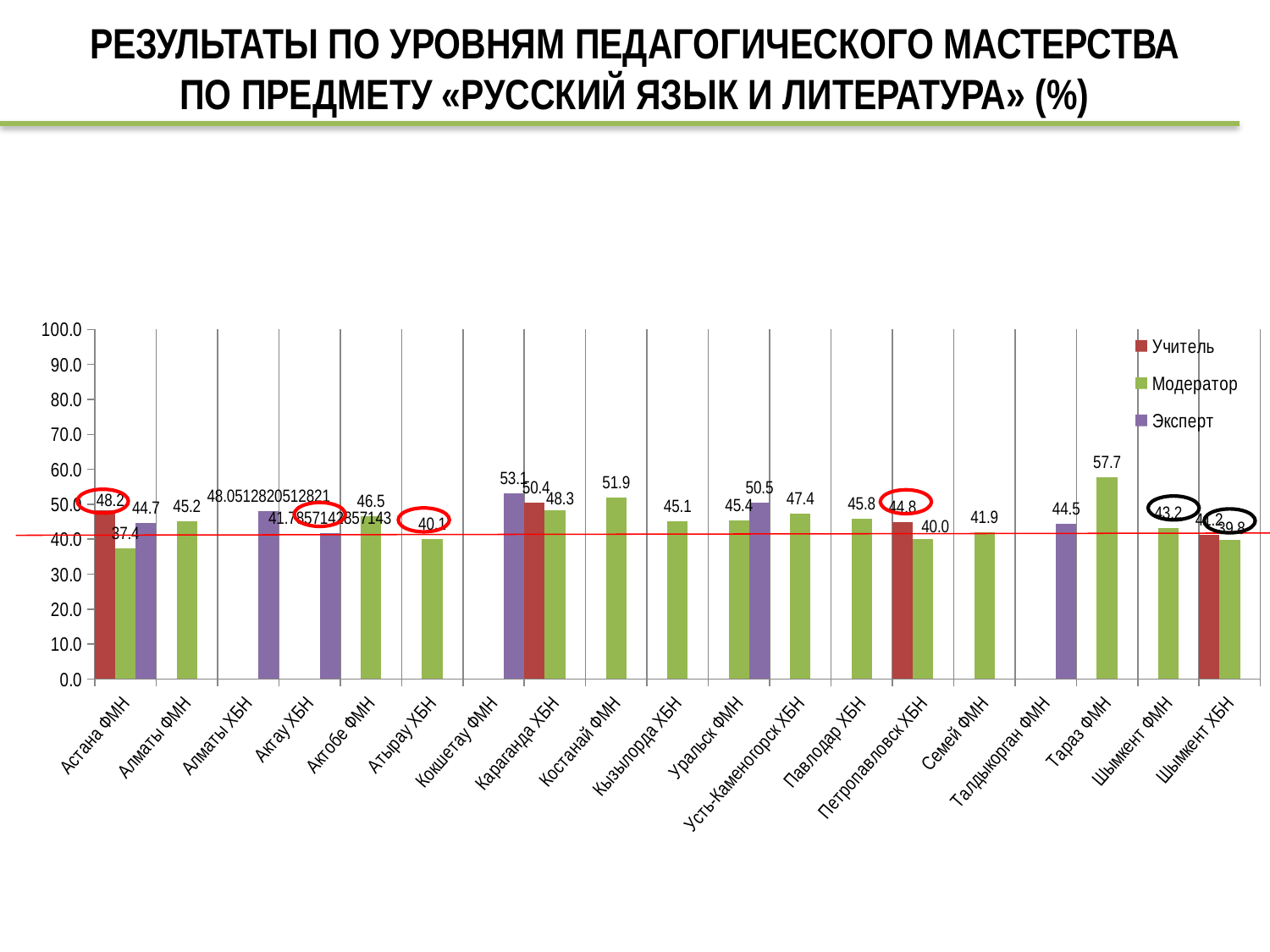
What is the Модератор value for Семей ФМН? 41.9 What is the Модератор value for Тараз ФМН? 57.7 Which category has the lowest Модератор value? Астана ФМН Which is larger for Уральск ФМН, the Модератор value or the Эксперт value? Эксперт Which series is shown in green in the legend? Модератор What is the Эксперт value for Кокшетау ФМН? 53.1 What is the difference between the Учитель and Модератор values for Петропавловск ХБН? 4.8 What is the Учитель value for Астана ФМН? 48.2 Which category has the highest Модератор value? Тараз ФМН Is the Модератор value for Костанай ФМН greater or less than 50.0? greater How many series does the legend list? 3 What type of chart is shown on the slide? bar chart